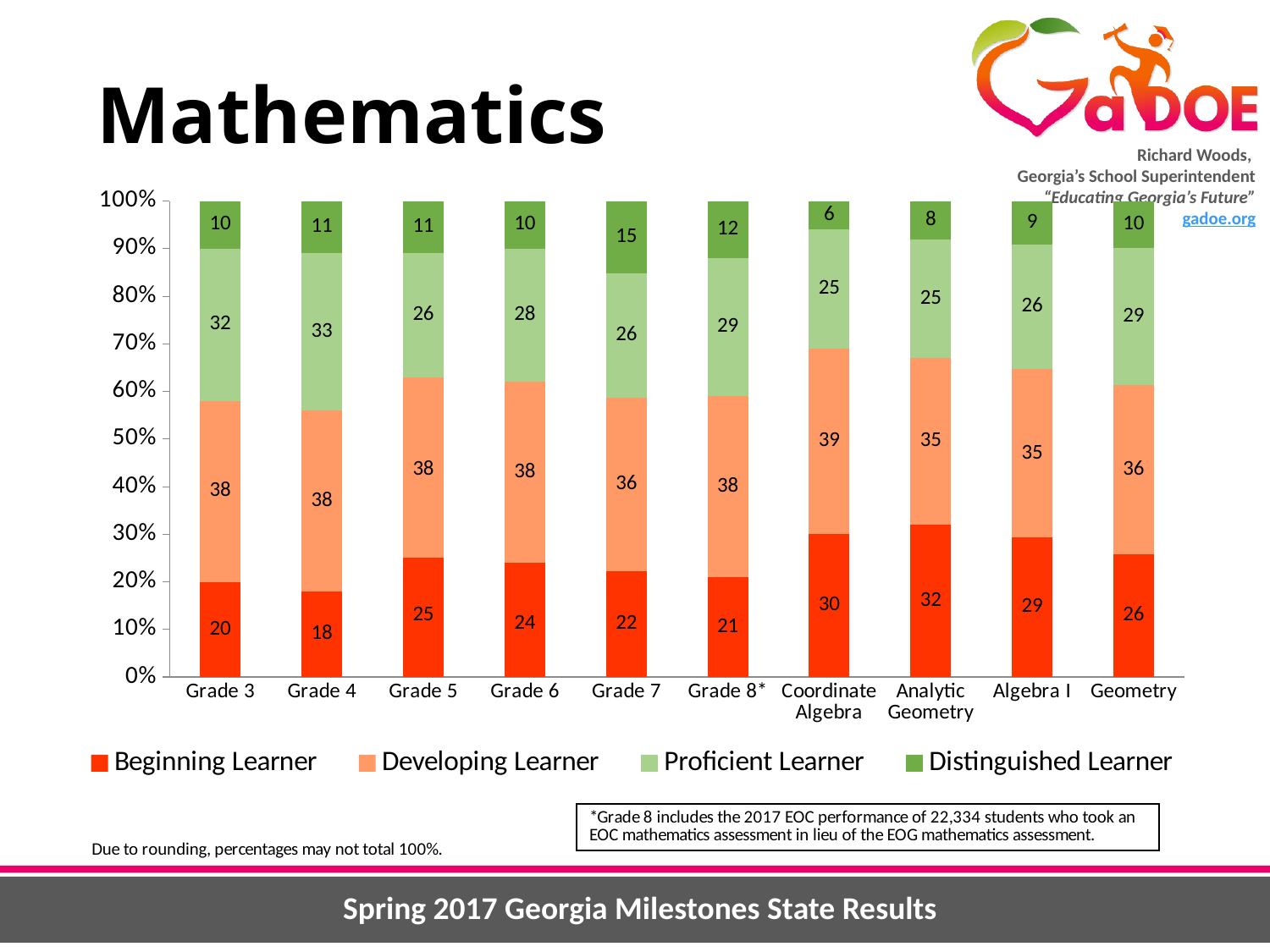
How many categories are shown on the x axis? 10 What is the Distinguished Learner value for Coordinate Algebra? 6 Which category has the lowest Beginning Learner value? Grade 4 Which category has the highest Distinguished Learner value? Grade 7 Which has a larger Proficient Learner value, Grade 3 or Grade 5? Grade 3 What is the Proficient Learner value for Grade 8*? 29 How many series does the legend list? 4 What is the Developing Learner value for Geometry? 36 Which category has the highest Developing Learner value? Coordinate Algebra What is the Beginning Learner percentage for Grade 3? 20 What kind of chart is shown on the slide? Stacked bar chart What is the difference between the Beginning Learner values for Analytic Geometry and Grade 4? 14